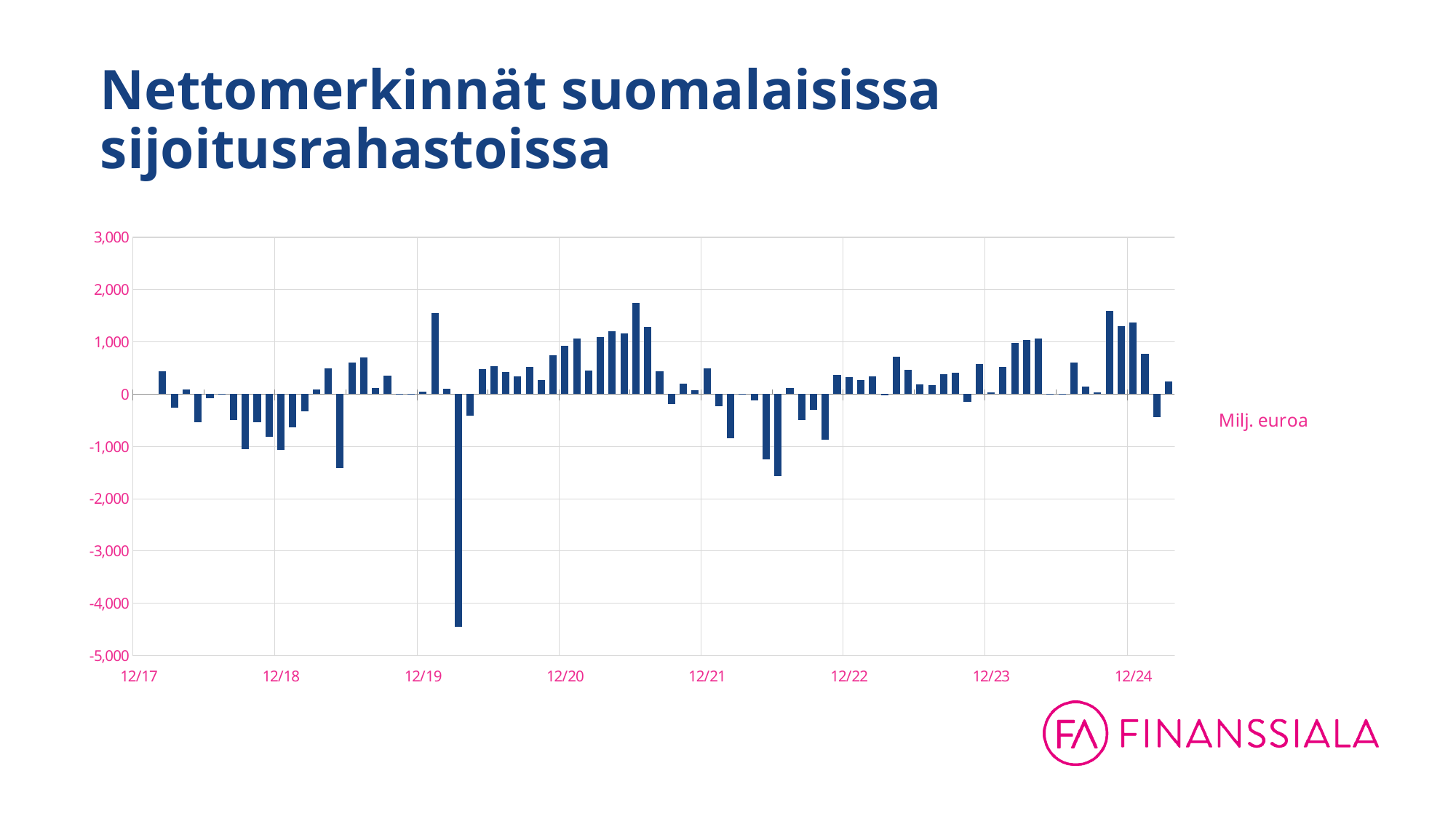
Is the highest bar on the chart greater or less than 1,000? greater Is the first bar on the chart, at 12/17, greater or less than 0? greater What is the first label on the horizontal axis of the chart? 12/17 What is the title of the chart on the slide? Nettomerkinnät suomalaisissa sijoitusrahastoissa What is the lowest value shown on the vertical axis of the chart? -5,000 How many labels are shown on the horizontal axis of the chart? 8 Is the lowest bar on the chart greater or less than -4,000? less What unit is indicated next to the chart? Milj. euroa What kind of chart is shown on the slide? Bar chart What is the highest value shown on the vertical axis of the chart? 3,000 Between which two horizontal-axis labels does the lowest bar of the chart fall? 12/19 and 12/20